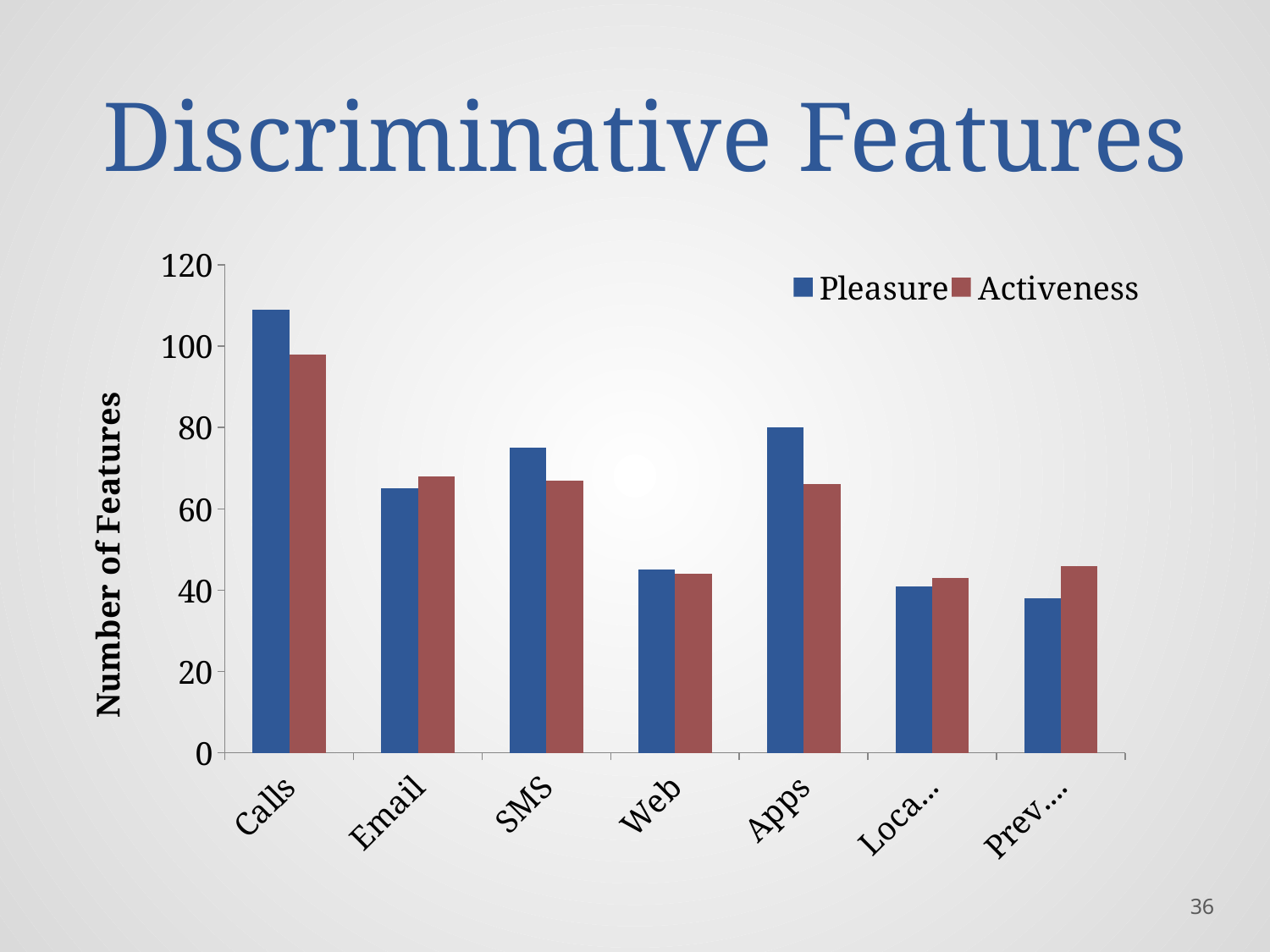
Which category has the highest Activeness value? Calls Is the Pleasure value for Calls greater or less than 100? greater For Apps, which series has the larger value, Pleasure or Activeness? Pleasure What kind of chart is shown on the slide? bar chart Which category has the highest Pleasure value? Calls Is the Pleasure value for SMS greater or less than 80? less For Calls, which series has the larger value, Pleasure or Activeness? Pleasure Is the Activeness value for Web greater or less than 60? less How many categories are shown on the x axis? 7 How many series does the legend list? 2 What is the label of the vertical axis? Number of Features